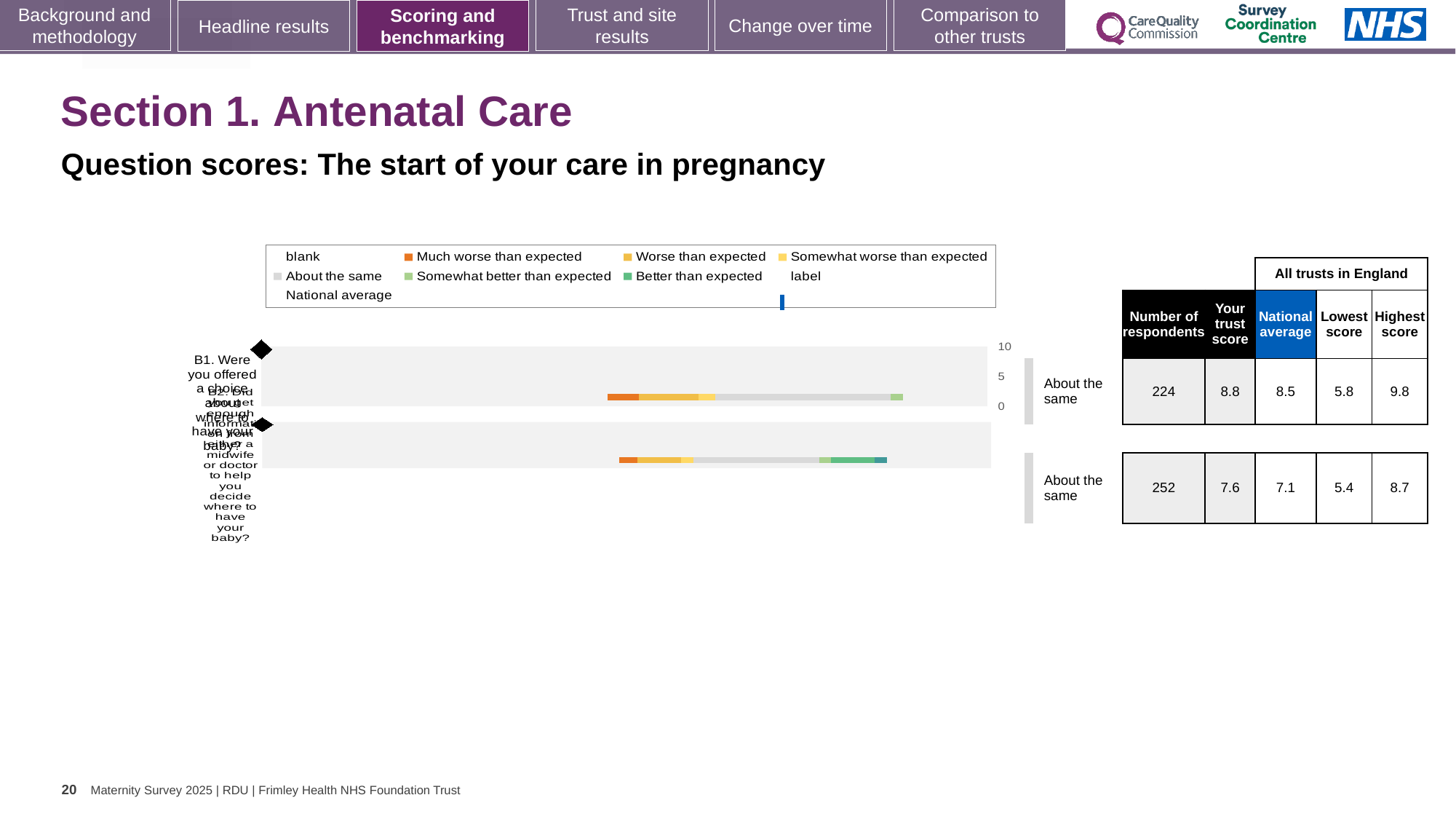
How many questions are plotted on the chart? 2 What is the trust's score for question B1 (Were you offered a choice about where to have your baby?)? 8.8 Is the trust's score for question B2 greater or less than 5? greater What is the difference between the highest and lowest scores for question B2? 3.3 What kind of chart is used to show the question scores? bar chart By how much does the trust's score for B1 exceed the national average for B1? 0.3 What is the highest score among all trusts in England for question B1? 9.8 What benchmark category is shown for question B2? About the same How many respondents answered question B1 (Were you offered a choice about where to have your baby?)? 224 What is the lowest score among all trusts in England for question B2? 5.4 Which question had more respondents, B1 or B2? B2 What is the national average score for question B2 (Did you get enough information to help you decide where to have your baby?)? 7.1